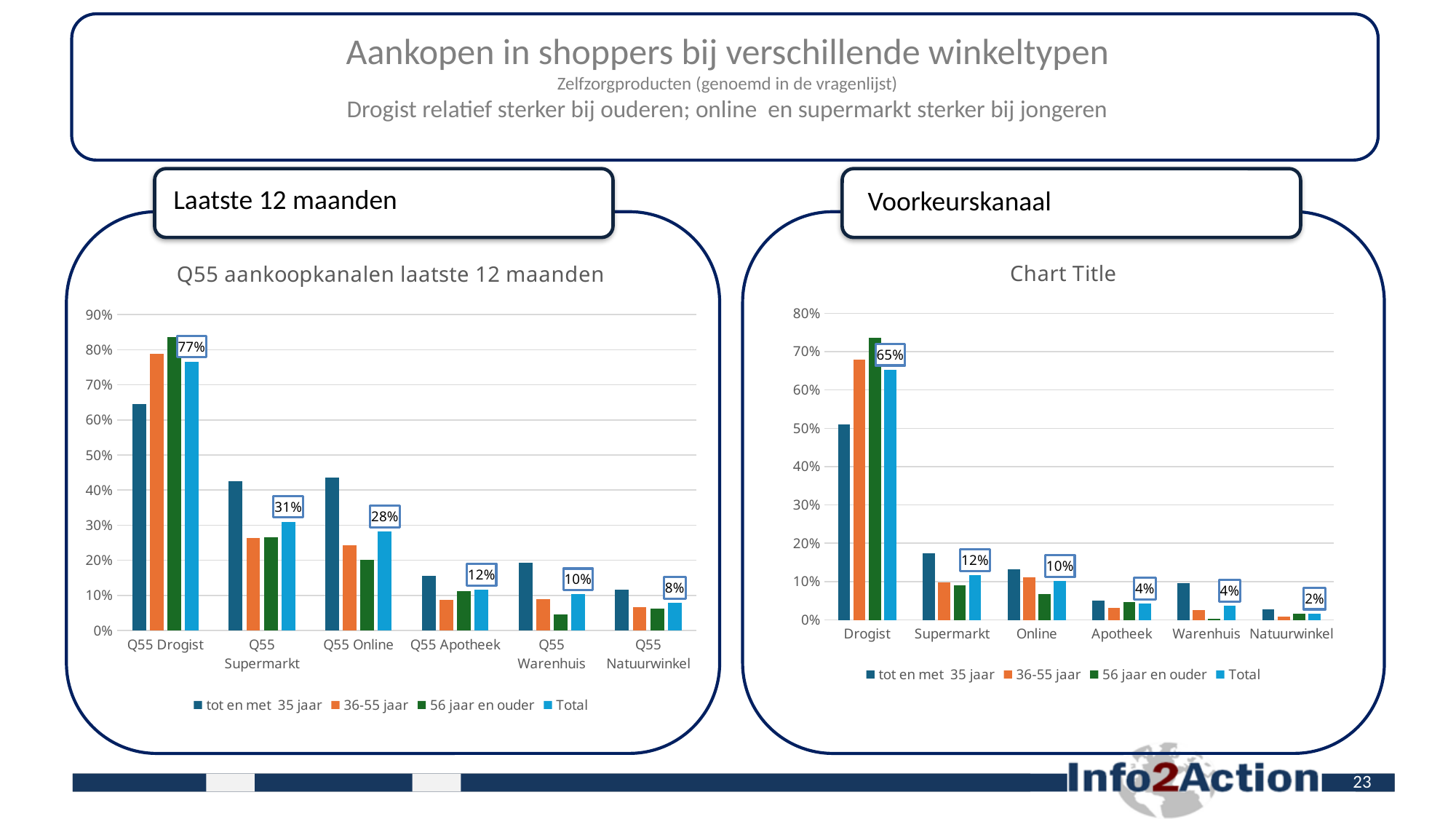
In the left chart titled 'Q55 aankoopkanalen laatste 12 maanden', which is larger for Q55 Drogist: the 'tot en met 35 jaar' bar or the '56 jaar en ouder' bar? 56 jaar en ouder In the right chart titled 'Chart Title', what is the Total value for Natuurwinkel? 2% In the left chart titled 'Q55 aankoopkanalen laatste 12 maanden', what is the Total value for Q55 Online? 28% In the left chart titled 'Q55 aankoopkanalen laatste 12 maanden', what is the Total value for Q55 Drogist? 77% In the left chart titled 'Q55 aankoopkanalen laatste 12 maanden', which category has the highest Total value? Q55 Drogist In the right chart titled 'Chart Title', what is the Total value for Supermarkt? 12% How many categories are shown on the x axis of the right chart titled 'Chart Title'? 6 In the right chart titled 'Chart Title', is the 'tot en met 35 jaar' value for Drogist greater or less than 60%? less How many series does the legend of the left chart titled 'Q55 aankoopkanalen laatste 12 maanden' list? 4 In the right chart titled 'Chart Title', what is the difference between the Total values for Drogist and Supermarkt? 53% In the right chart titled 'Chart Title', which category has the lowest Total value? Natuurwinkel In the left chart titled 'Q55 aankoopkanalen laatste 12 maanden', what is the difference between the Total values for Q55 Supermarkt and Q55 Online? 3%